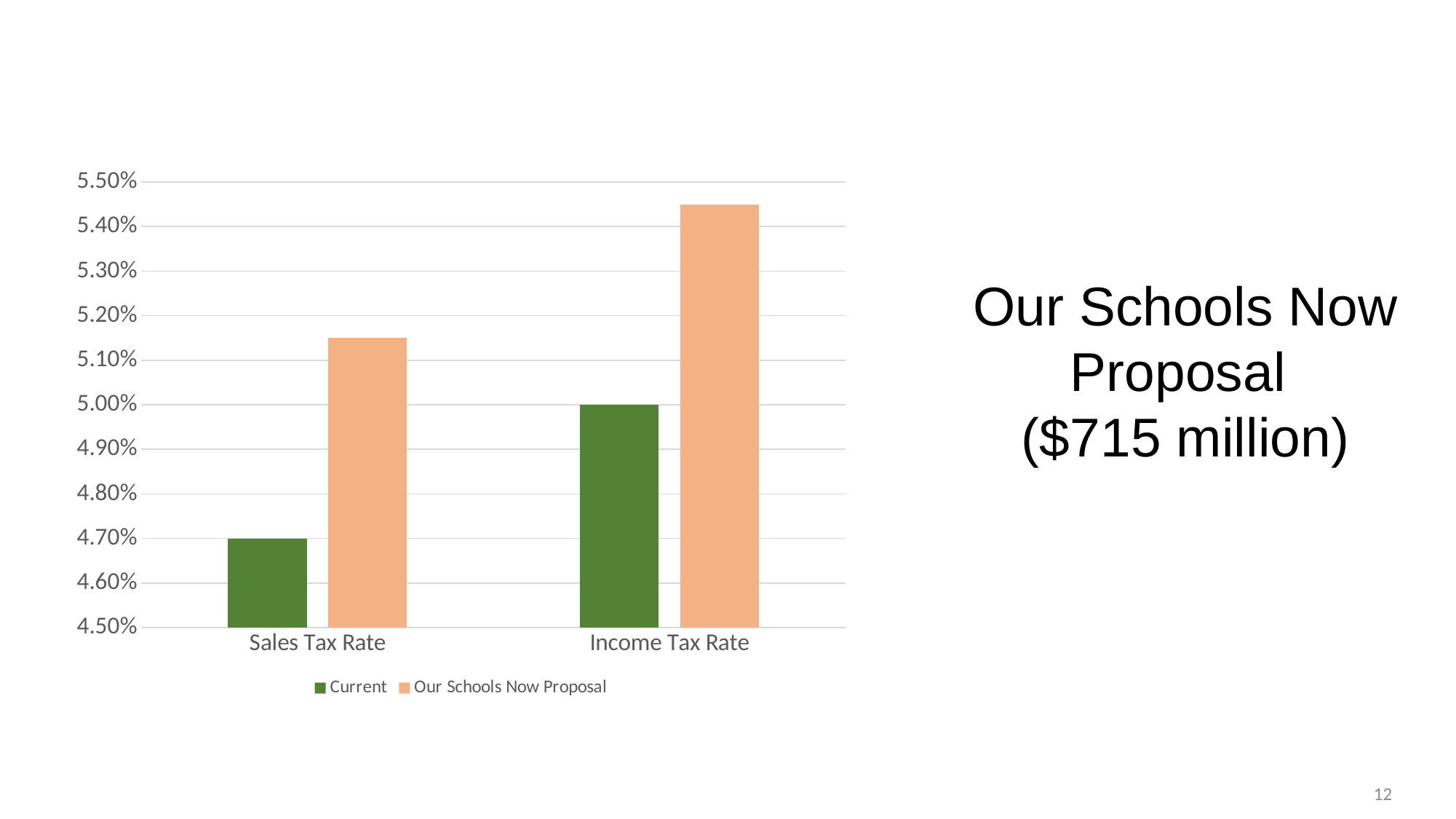
What is the Current income tax rate shown in the chart? 5.00% Is the Our Schools Now Proposal value for Income Tax Rate greater or less than 5.40%? greater Is the Our Schools Now Proposal value for Sales Tax Rate greater or less than 5.10%? greater What is the difference between the Current income tax rate and the Current sales tax rate? 0.30% What is the Current sales tax rate shown in the chart? 4.70% Which bar in the chart is the tallest? Our Schools Now Proposal for Income Tax Rate How many series does the chart legend list? 2 How many categories are shown on the x axis of the chart? 2 Is the Our Schools Now Proposal value for Sales Tax Rate greater or less than 5.20%? less Which bar in the chart is the shortest? Current for Sales Tax Rate What type of chart is shown on the slide? Bar chart Which is larger for the Current series: the Sales Tax Rate or the Income Tax Rate? Income Tax Rate